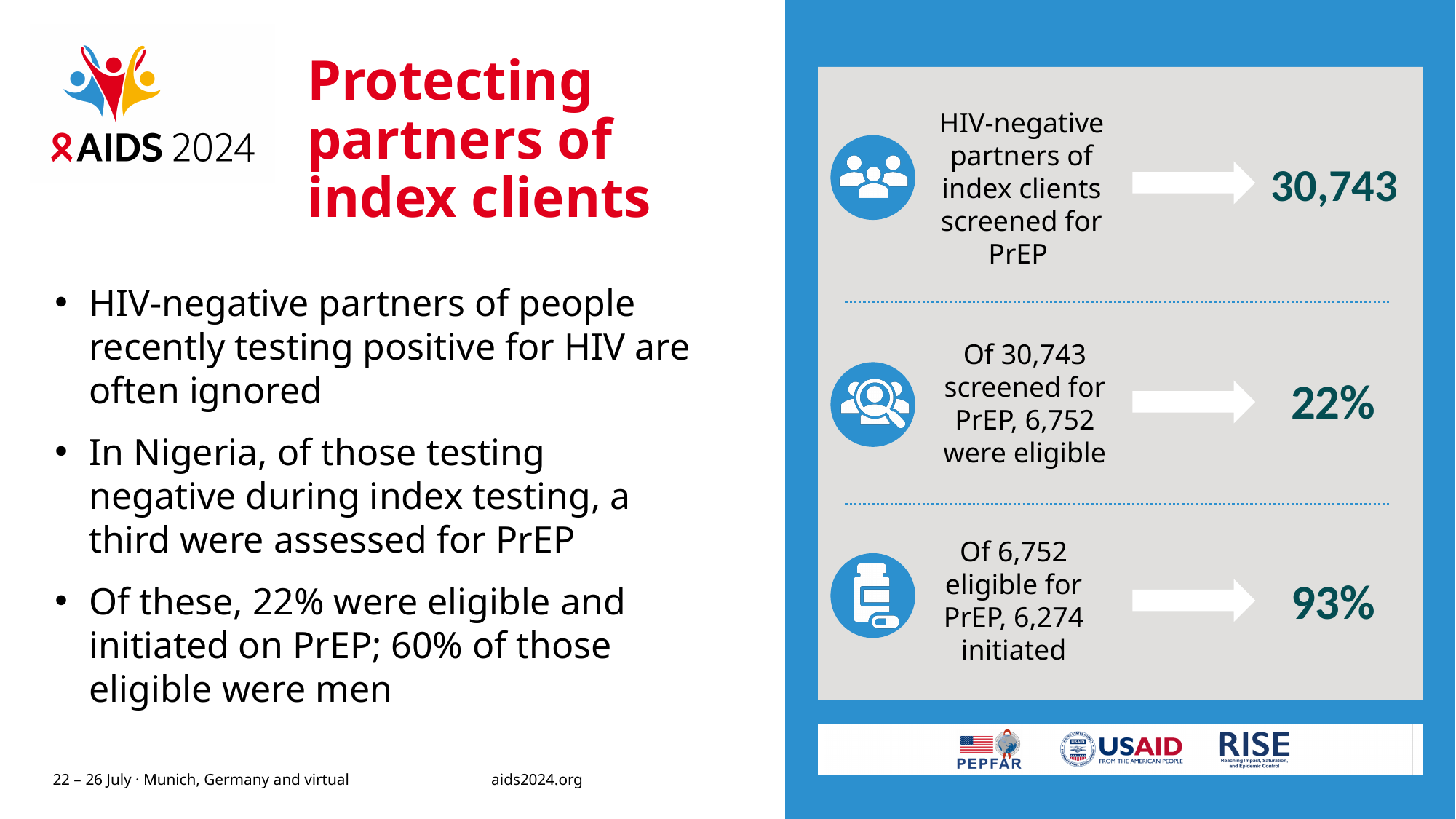
What is the title of the slide containing the infographic? Protecting partners of index clients In the infographic on the right, which percentage is larger: the share eligible (22%) or the share initiated (93%)? 93% In the infographic on the right, what percentage of those screened for PrEP were eligible? 22% In the infographic on the right, what percentage of those eligible for PrEP initiated? 93% In the infographic on the right, which step has the largest number of people? HIV-negative partners of index clients screened for PrEP In the infographic on the right, how many steps (rows) are shown? 3 In the infographic on the right, which step has the smallest number of people? Of 6,752 eligible for PrEP, 6,274 initiated In the infographic on the right, how many more people were screened for PrEP than were eligible? 23,991 In the infographic on the right, how many more people were eligible for PrEP than initiated? 478 In the infographic on the right, how many of the 30,743 screened for PrEP were eligible? 6,752 In the infographic on the right, how many HIV-negative partners of index clients were screened for PrEP? 30,743 In the infographic on the right, how many of the 6,752 eligible for PrEP initiated? 6,274